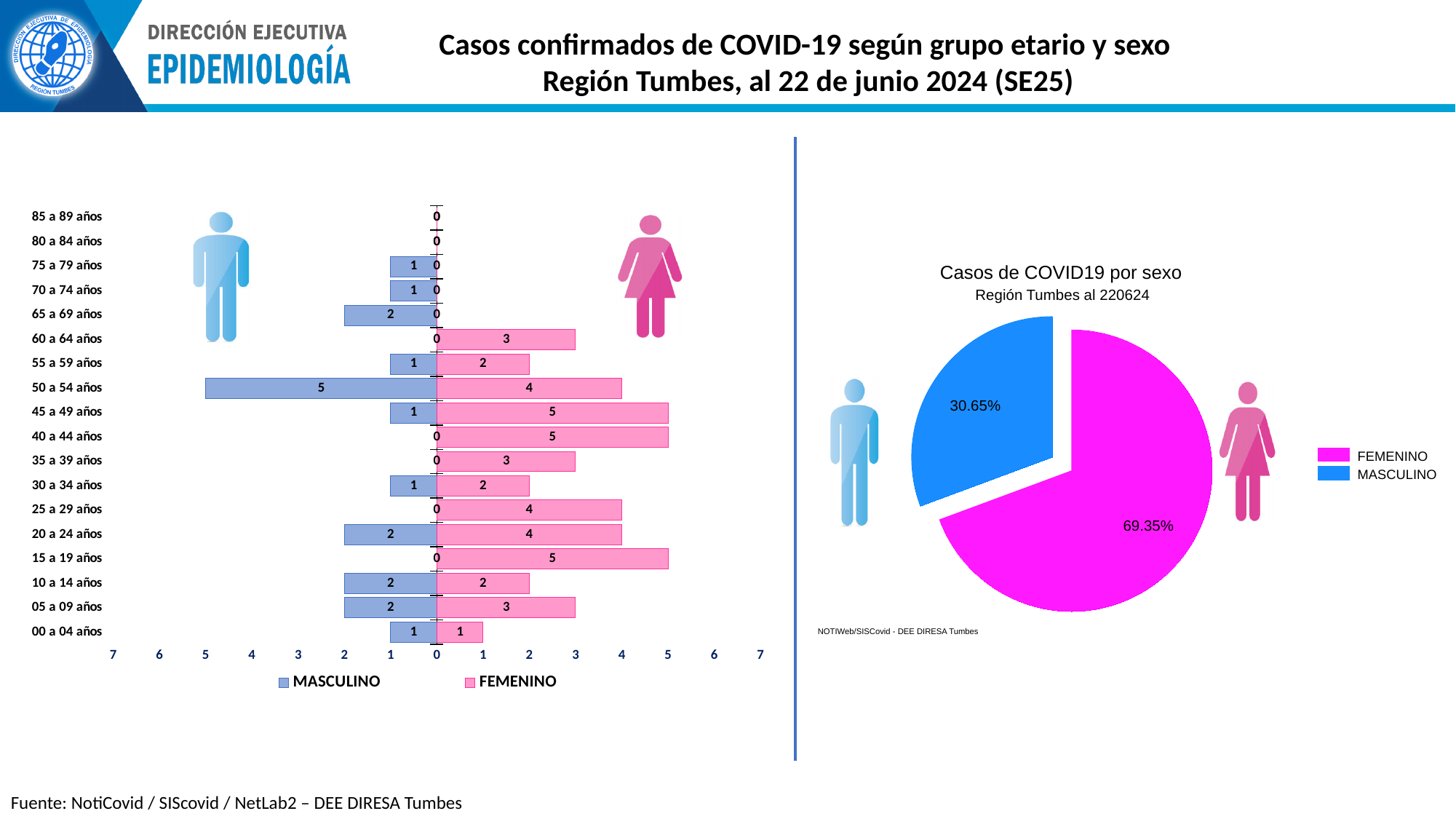
In the pie chart 'Casos de COVID19 por sexo', what share is FEMENINO? 69.35% In the left bar chart, what is the FEMENINO value for the 45 a 49 años group? 5 In the left bar chart, what is the FEMENINO value for the 60 a 64 años group? 3 What kind of chart is the chart on the left of the slide? Bar chart In the left bar chart, which is larger for the 50 a 54 años group, the MASCULINO value or the FEMENINO value? MASCULINO In the pie chart 'Casos de COVID19 por sexo', which slice is smaller, FEMENINO or MASCULINO? MASCULINO How many age groups are shown in the left bar chart? 18 In the left bar chart, what is the MASCULINO value for the 50 a 54 años group? 5 In the left bar chart, what is the total of the MASCULINO and FEMENINO values for the 05 a 09 años group? 5 In the left bar chart, which age group has the highest MASCULINO value? 50 a 54 años In the left bar chart, what is the difference between the FEMENINO and MASCULINO values for the 20 a 24 años group? 2 How many series does the legend of the left bar chart list? 2